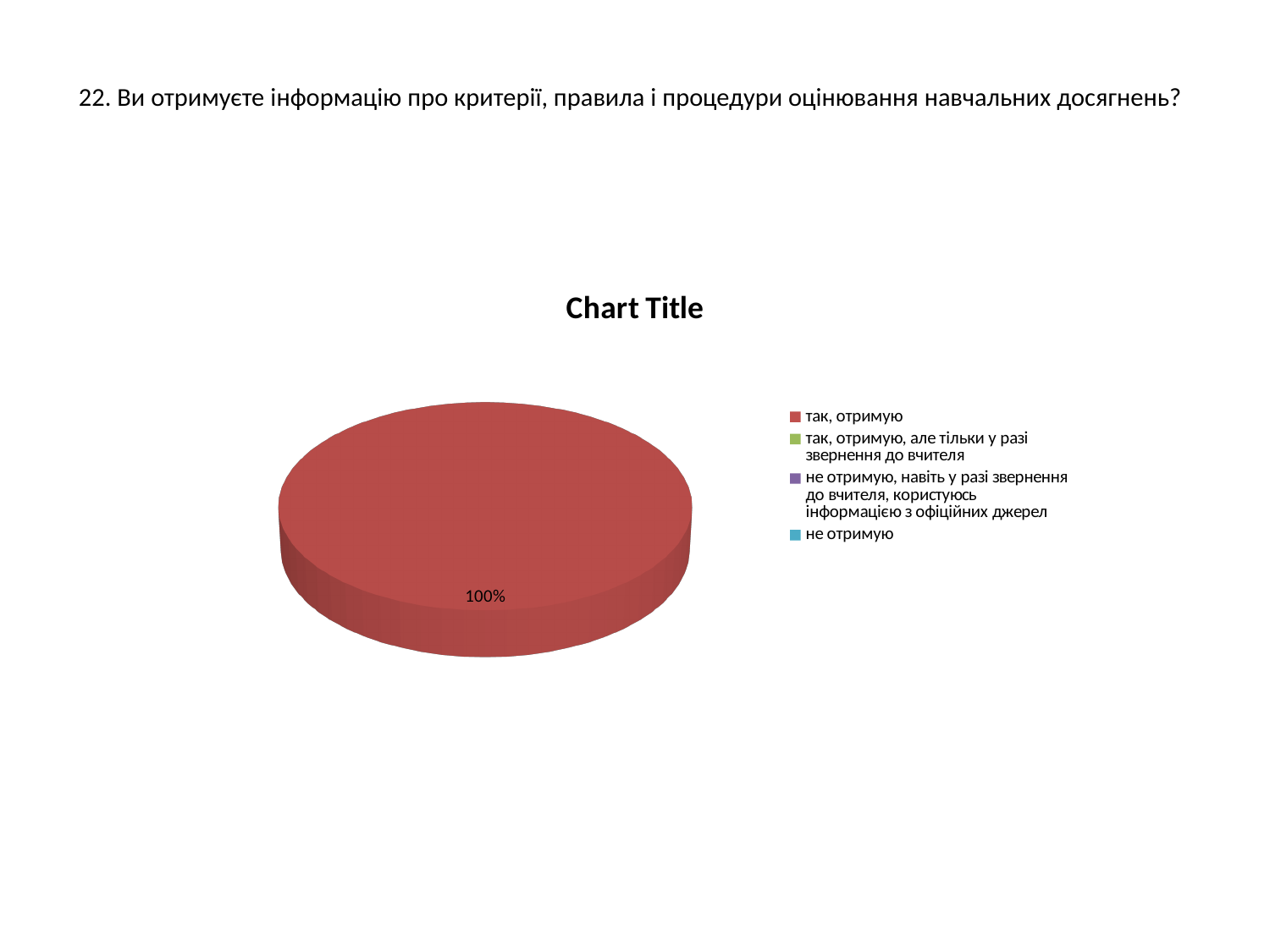
How many slices are visible in the pie? 1 Is the share for "так, отримую" greater or less than 50%? greater What colour is the "так, отримую" slice? red Which is larger: the share for "так, отримую" or the share for "не отримую"? так, отримую What is the title shown above the chart? Chart Title How many entries does the legend list? 4 What is the data label printed on the pie slice? 100% Which category has the largest share of the pie? так, отримую What kind of chart is shown on the slide? pie chart What share of the pie does the "так, отримую" slice take? 100%